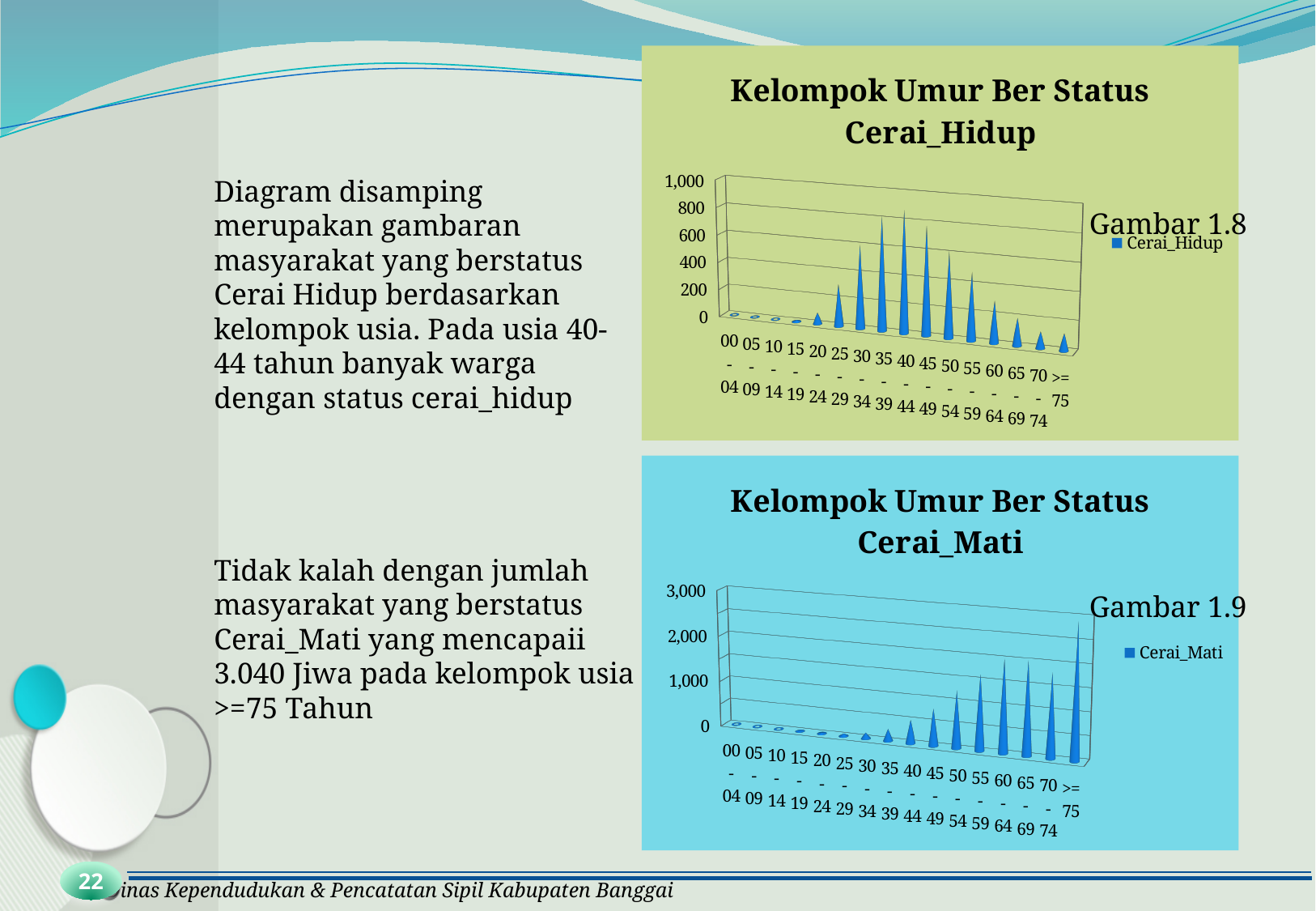
In the chart titled "Kelompok Umur Ber Status Cerai_Hidup", which is larger: the value for 40 - 44 or the value for 70 - 74? 40 - 44 In the chart titled "Kelompok Umur Ber Status Cerai_Mati", is the value for the >= 75 age group greater or less than 2,000? greater How many age-group categories are shown on the x axis of the chart titled "Kelompok Umur Ber Status Cerai_Mati"? 16 In the chart titled "Kelompok Umur Ber Status Cerai_Hidup", is the value for the 20 - 24 age group greater or less than 200? less In the chart titled "Kelompok Umur Ber Status Cerai_Mati", which age group has the highest value? >= 75 How many series does the legend of the chart titled "Kelompok Umur Ber Status Cerai_Hidup" list? 1 In the chart titled "Kelompok Umur Ber Status Cerai_Mati", do the values generally rise or fall as the age groups increase along the x axis? rise In the chart titled "Kelompok Umur Ber Status Cerai_Mati", which is larger: the value for >= 75 or the value for 40 - 44? >= 75 In the chart titled "Kelompok Umur Ber Status Cerai_Mati", is the value for the 30 - 34 age group greater or less than 1,000? less In the chart titled "Kelompok Umur Ber Status Cerai_Hidup", which age group has the highest value? 40 - 44 What kind of chart is the chart titled "Kelompok Umur Ber Status Cerai_Mati"? bar chart